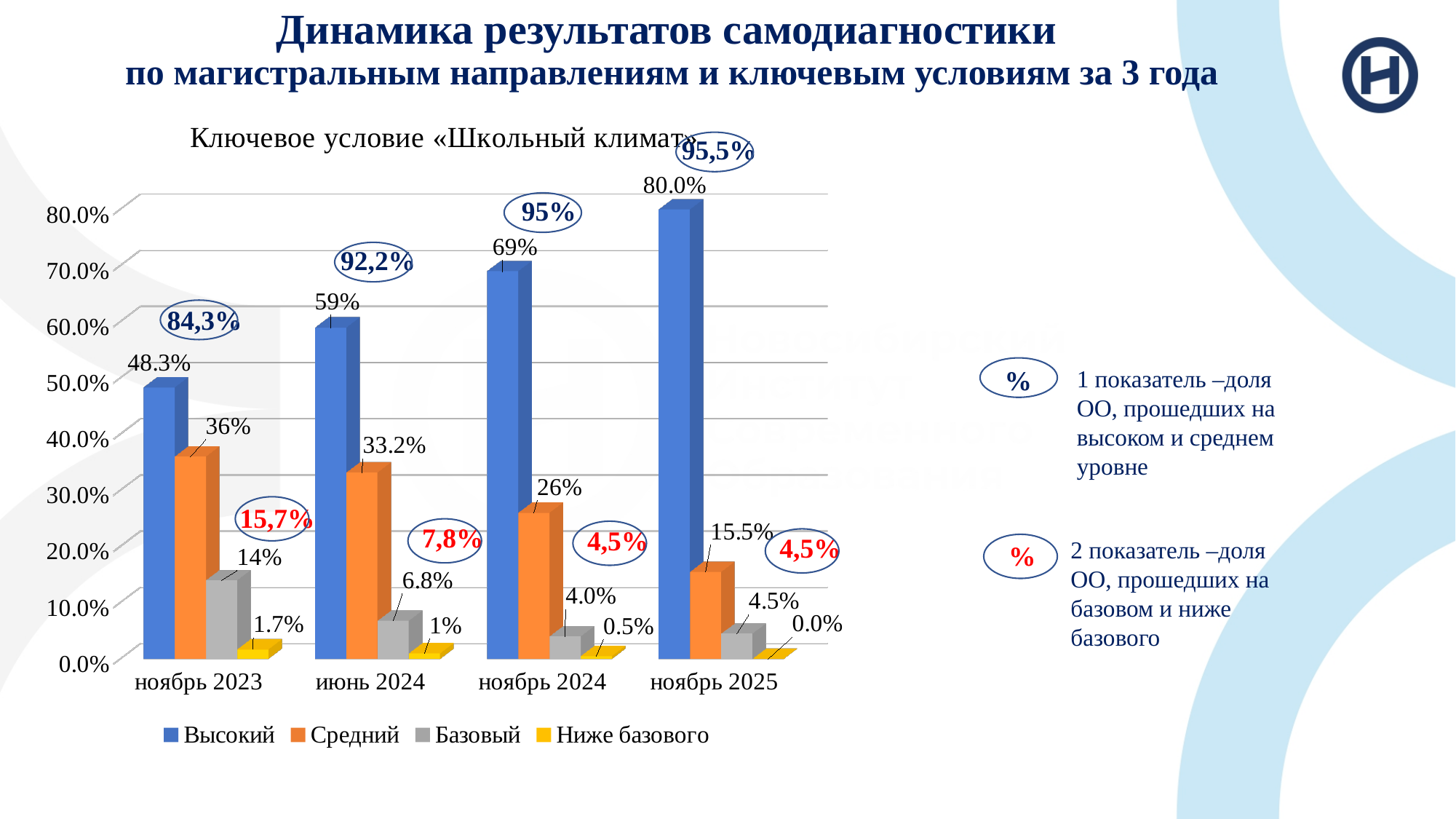
Does the Высокий value rise or fall from ноябрь 2023 to ноябрь 2025? rise How many series does the legend list? 4 What is the value for Базовый in ноябрь 2023? 14% How many periods are shown on the x axis? 4 What is the value for Высокий in ноябрь 2025? 80.0% What is the value for Ниже базового in ноябрь 2024? 0.5% What is the difference between the Высокий values for ноябрь 2025 and ноябрь 2023? 31.7% What is the value for Средний in июнь 2024? 33.2% In which period is the Средний value lowest? ноябрь 2025 In which period is the Высокий value highest? ноябрь 2025 Which is larger: Средний in ноябрь 2023 or Средний in ноябрь 2024? ноябрь 2023 What kind of chart is shown? bar chart